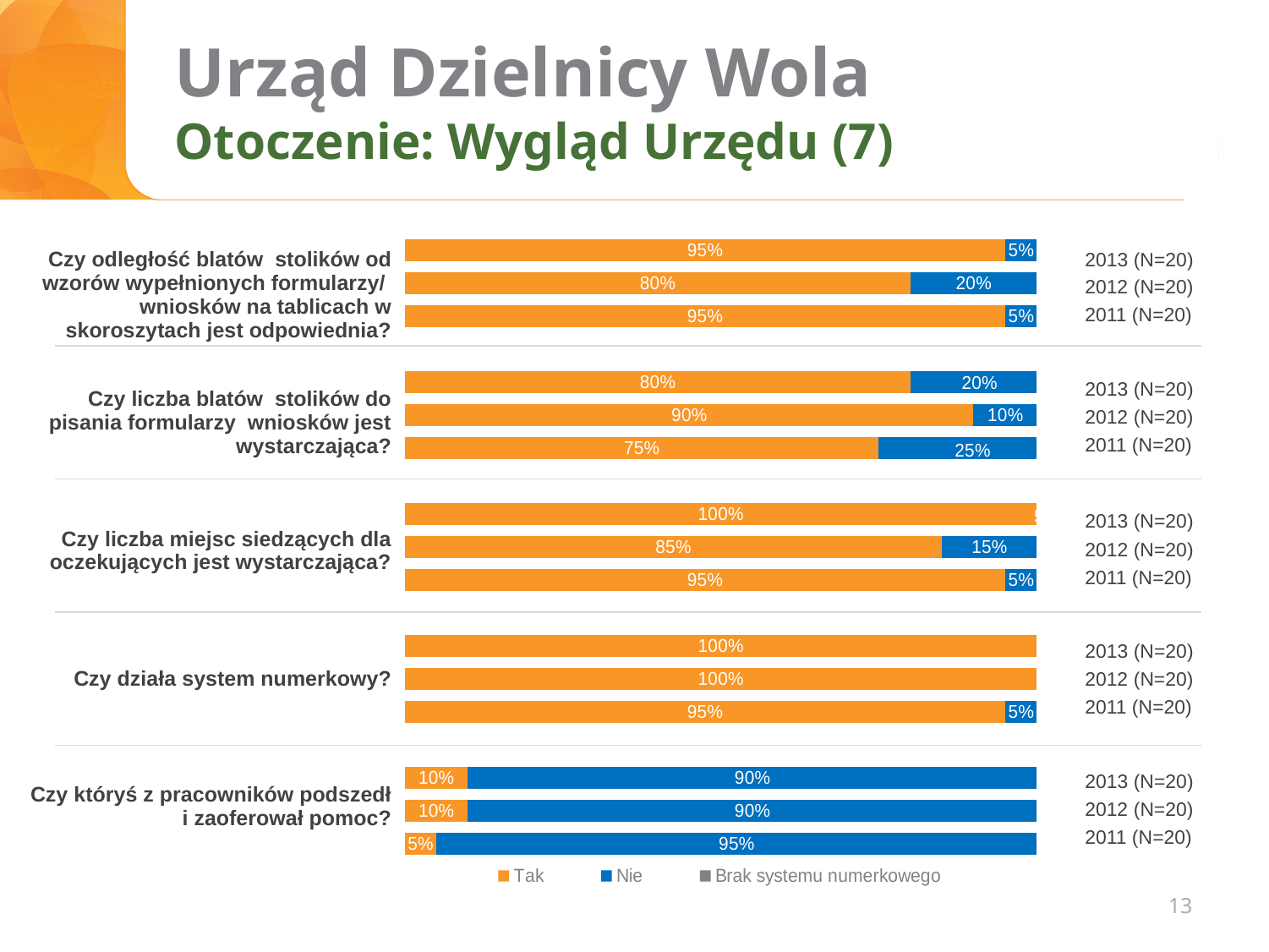
In the chart for "Czy odległość blatów stolików od wzorów wypełnionych formularzy/wniosków na tablicach w skoroszytach jest odpowiednia?", what is the "Tak" value for 2012 (N=20)? 80% How many bars are shown in the chart for "Czy działa system numerkowy?"? 3 In the chart for "Czy któryś z pracowników podszedł i zaoferował pomoc?", what is the "Nie" value for 2011 (N=20)? 95% In the chart for "Czy liczba miejsc siedzących dla oczekujących jest wystarczająca?", which year has the lowest "Tak" value? 2012 (N=20) How many series does the legend at the bottom of the slide list? 3 In the chart for "Czy liczba blatów stolików do pisania formularzy wniosków jest wystarczająca?", which year has the highest "Tak" value? 2012 (N=20) In the chart for "Czy liczba miejsc siedzących dla oczekujących jest wystarczająca?", what is the "Tak" value for 2013 (N=20)? 100% In the chart for "Czy liczba blatów stolików do pisania formularzy wniosków jest wystarczająca?", what is the "Nie" value for 2011 (N=20)? 25% In the chart for "Czy działa system numerkowy?", is the "Tak" value for 2012 larger or smaller than the "Tak" value for 2011? larger Which colour represents "Nie" in the legend? Blue What kind of chart is used on this slide? Stacked bar chart In the chart for "Czy odległość blatów stolików od wzorów wypełnionych formularzy/wniosków na tablicach w skoroszytach jest odpowiednia?", what is the difference between the "Tak" values for 2013 and 2012? 15%